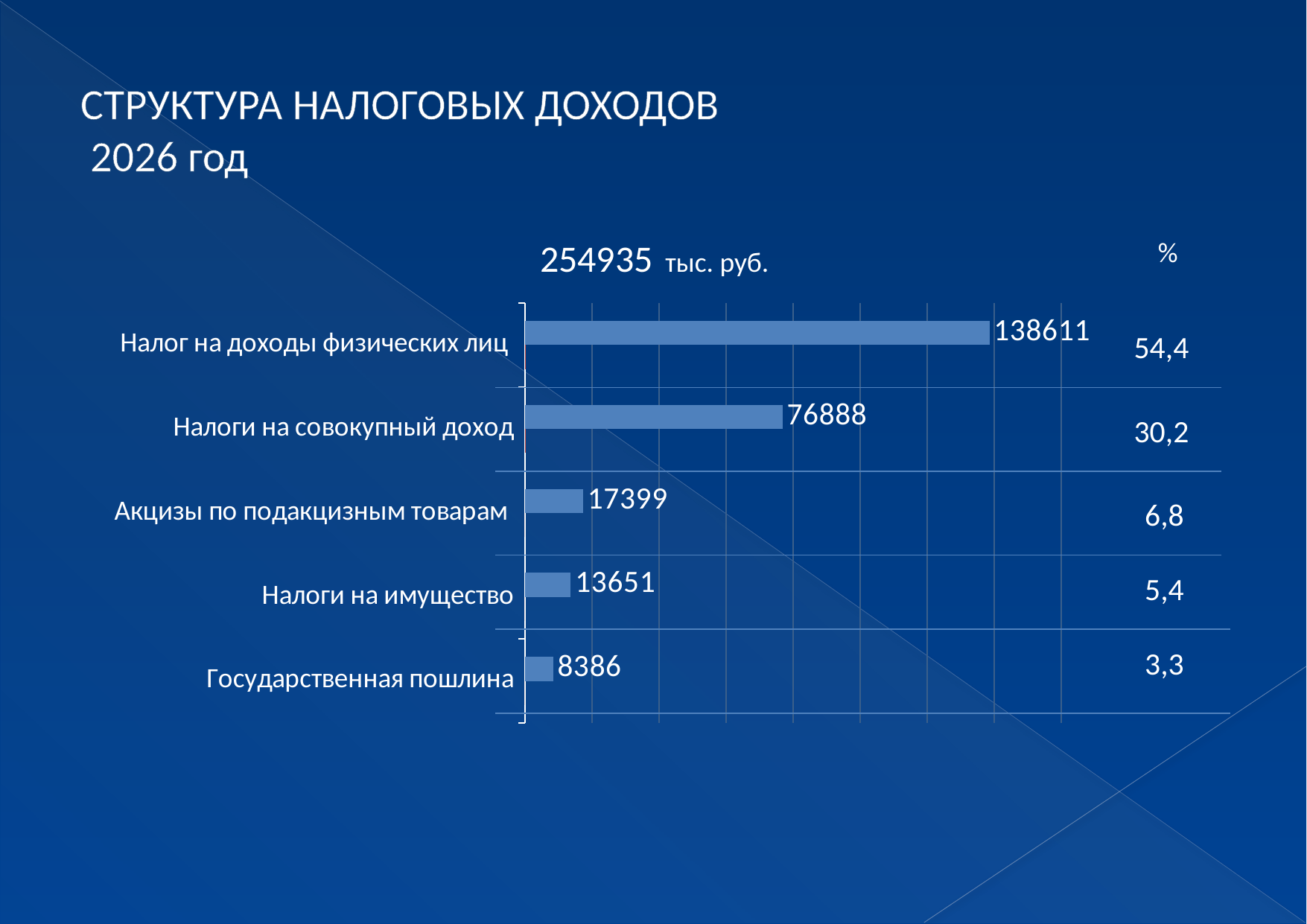
What is the difference between the values for Акцизы по подакцизным товарам and Налоги на имущество? 3748 What is the value for Налог на доходы физических лиц? 138611 Which category has the lowest value? Государственная пошлина What kind of chart is shown on the slide? bar chart Which is larger, the value for Налоги на имущество or the value for Государственная пошлина? Налоги на имущество What percentage share is listed next to Налоги на совокупный доход? 30,2 What is the value for Государственная пошлина? 8386 What is the value for Налоги на совокупный доход? 76888 What is the difference between the values for Налог на доходы физических лиц and Налоги на совокупный доход? 61723 What is the value for Акцизы по подакцизным товарам? 17399 How many categories are shown in the chart? 5 Which category has the highest value? Налог на доходы физических лиц